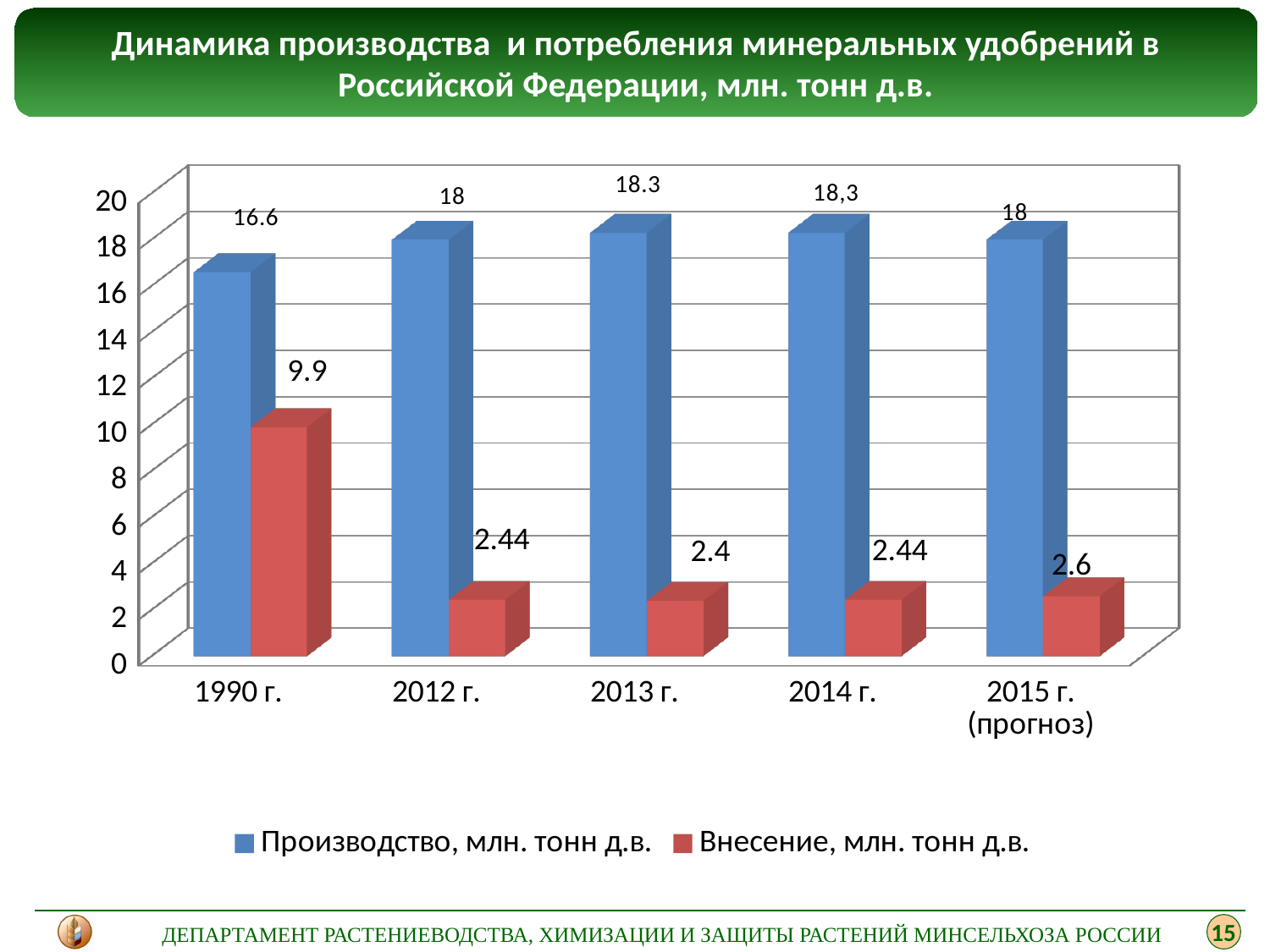
What is the value of Производство, млн. тонн д.в. for 2014 г.? 18,3 What is the value of Внесение, млн. тонн д.в. for 2013 г.? 2.4 What is the value of Производство, млн. тонн д.в. for 1990 г.? 16.6 In which year is Производство, млн. тонн д.в. the lowest? 1990 г. What is the difference between Производство and Внесение in 1990 г.? 6.7 Which year has the larger value of Внесение, млн. тонн д.в.: 2012 г. or 2013 г.? 2012 г. In which year is Внесение, млн. тонн д.в. the highest? 1990 г. What is the value of Внесение, млн. тонн д.в. for 2015 г. (прогноз)? 2.6 What kind of chart is shown on the slide? bar chart What is the value of Внесение, млн. тонн д.в. for 1990 г.? 9.9 How many series does the legend list? 2 How many years are shown on the x axis? 5